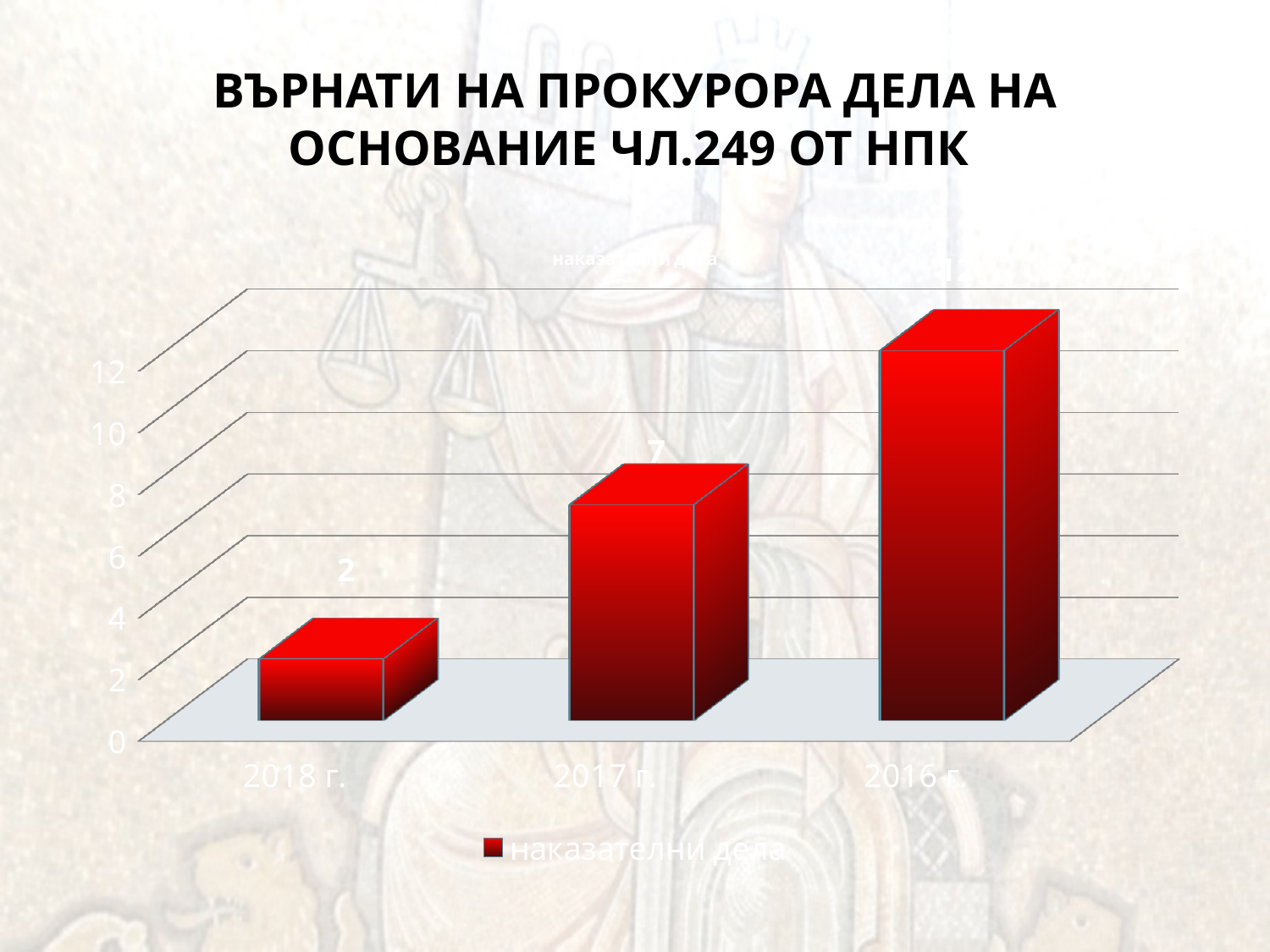
What is the value for 2017 г.? 7 What is the difference between the values for 2016 г. and 2018 г.? 10 Is the value for 2017 г. greater or less than 6? greater What is the difference between the values for 2017 г. and 2018 г.? 5 Which is larger, the value for 2017 г. or the value for 2018 г.? 2017 г. What is the value for 2018 г.? 2 What is the value for 2016 г.? 12 How many years are shown on the x axis? 3 What kind of chart is shown on the slide? bar chart What series name does the legend show? наказателни дела Which year has the lowest value? 2018 г. Which year has the highest value? 2016 г.